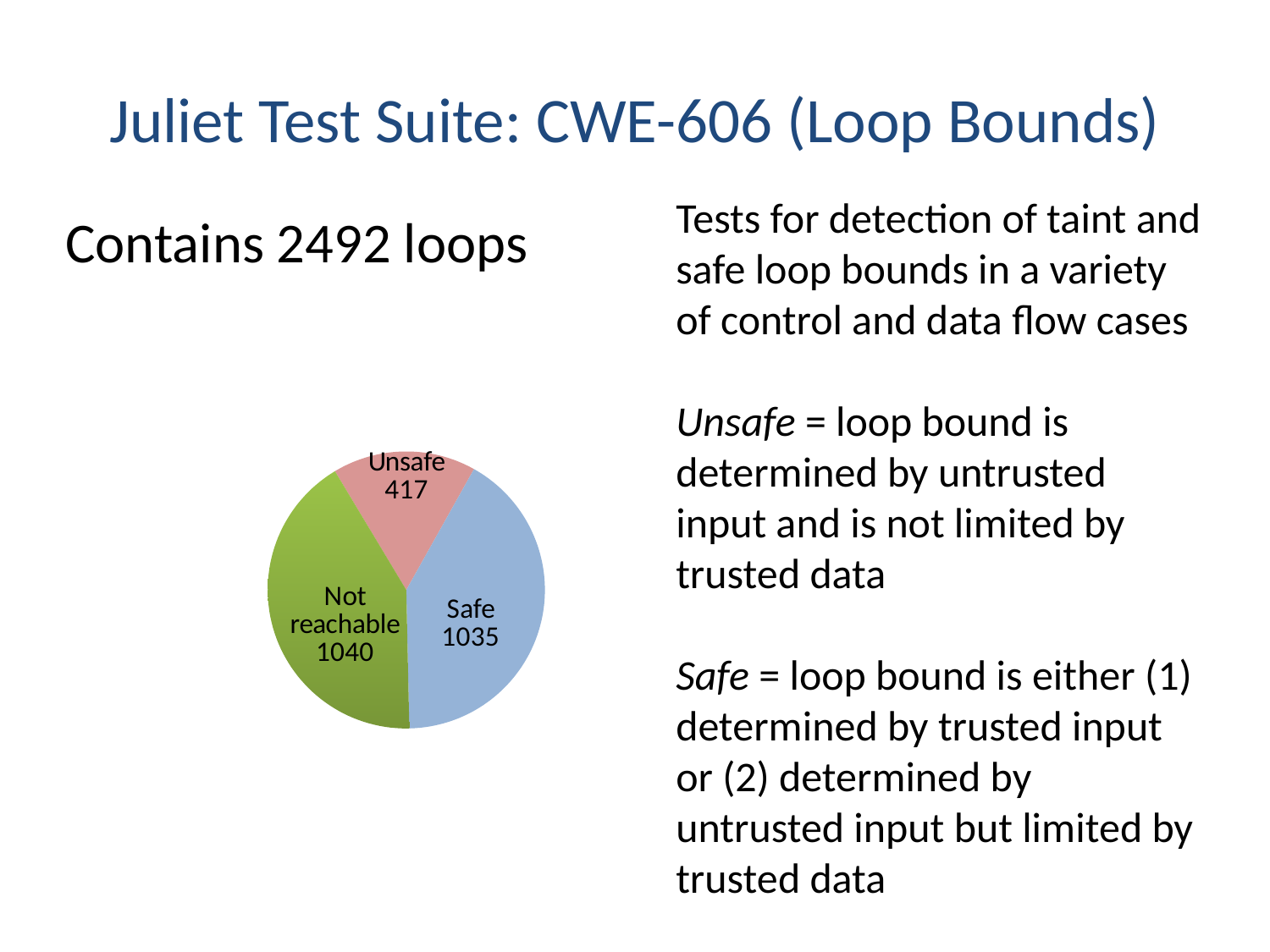
Which is larger, the Safe slice or the Unsafe slice? Safe What colour is the Not reachable slice? green What is the total of all three slices in the pie chart? 2492 Which slice of the pie chart is the smallest? Unsafe What is the difference between the Safe value and the Unsafe value? 618 How many slices does the pie chart have? 3 What kind of chart is shown on the slide? pie chart What is the value for the Safe slice? 1035 What is the value for the Unsafe slice? 417 What is the difference between the Not reachable value and the Safe value? 5 What is the value for the Not reachable slice? 1040